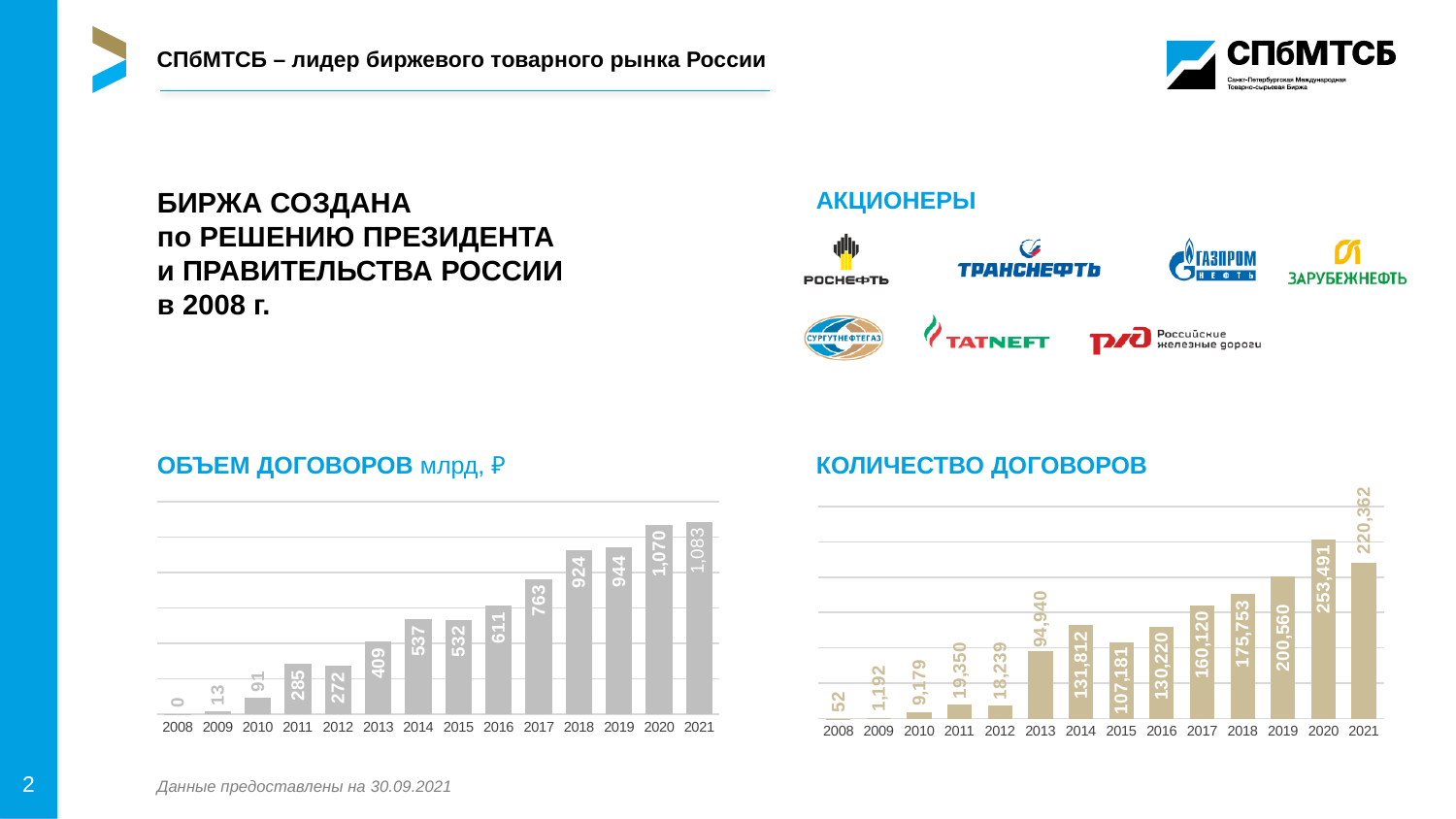
In the 'КОЛИЧЕСТВО ДОГОВОРОВ' chart, which year has the highest value? 2020 In the 'КОЛИЧЕСТВО ДОГОВОРОВ' chart, which year has the lowest value? 2008 In the 'ОБЪЕМ ДОГОВОРОВ' chart, how many years are shown on the x axis? 14 In the 'КОЛИЧЕСТВО ДОГОВОРОВ' chart, what is the difference between the values for 2020 and 2021? 33,129 What kind of chart is the 'ОБЪЕМ ДОГОВОРОВ' chart? bar chart In the 'ОБЪЕМ ДОГОВОРОВ' chart, which is larger, the value for 2011 or the value for 2012? 2011 In the 'КОЛИЧЕСТВО ДОГОВОРОВ' chart, what is the value for 2019? 200,560 In the 'КОЛИЧЕСТВО ДОГОВОРОВ' chart, which is larger, the value for 2014 or the value for 2015? 2014 What unit is given in the title of the left chart, 'ОБЪЕМ ДОГОВОРОВ'? млрд, ₽ In the 'ОБЪЕМ ДОГОВОРОВ' chart, what is the difference between the values for 2021 and 2020? 13 In the 'ОБЪЕМ ДОГОВОРОВ' chart, what is the value for 2017? 763 In the 'ОБЪЕМ ДОГОВОРОВ' chart, which year has the highest value? 2021